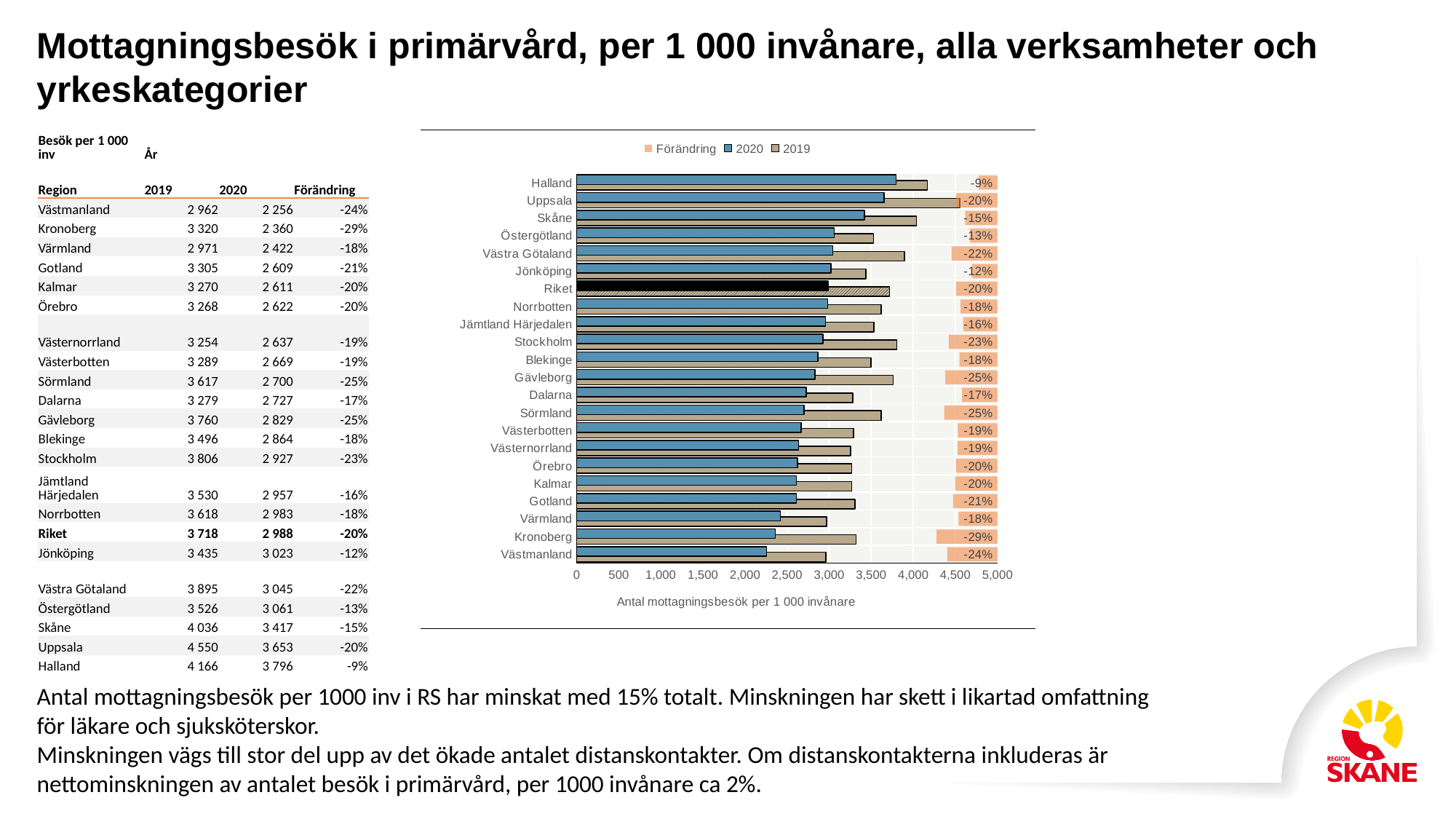
What is the Förändring value shown for Kronoberg? -29% What is the Förändring value shown for Halland? -9% Is the 2020 value for Västmanland greater or less than 2,500? less How many series does the chart legend list? 3 What kind of chart is shown on the slide? bar chart How many regions (categories) are plotted on the chart's vertical axis? 22 Which region has the smallest percentage decrease (Förändring) on the chart? Halland Which region has the largest percentage decrease (Förändring) on the chart? Kronoberg What is the title of the chart's horizontal axis? Antal mottagningsbesök per 1 000 invånare Is the 2020 value for Halland greater or less than 3,500? greater Which region has the larger 2020 value, Halland or Uppsala? Halland What is the Förändring value shown for Skåne? -15%